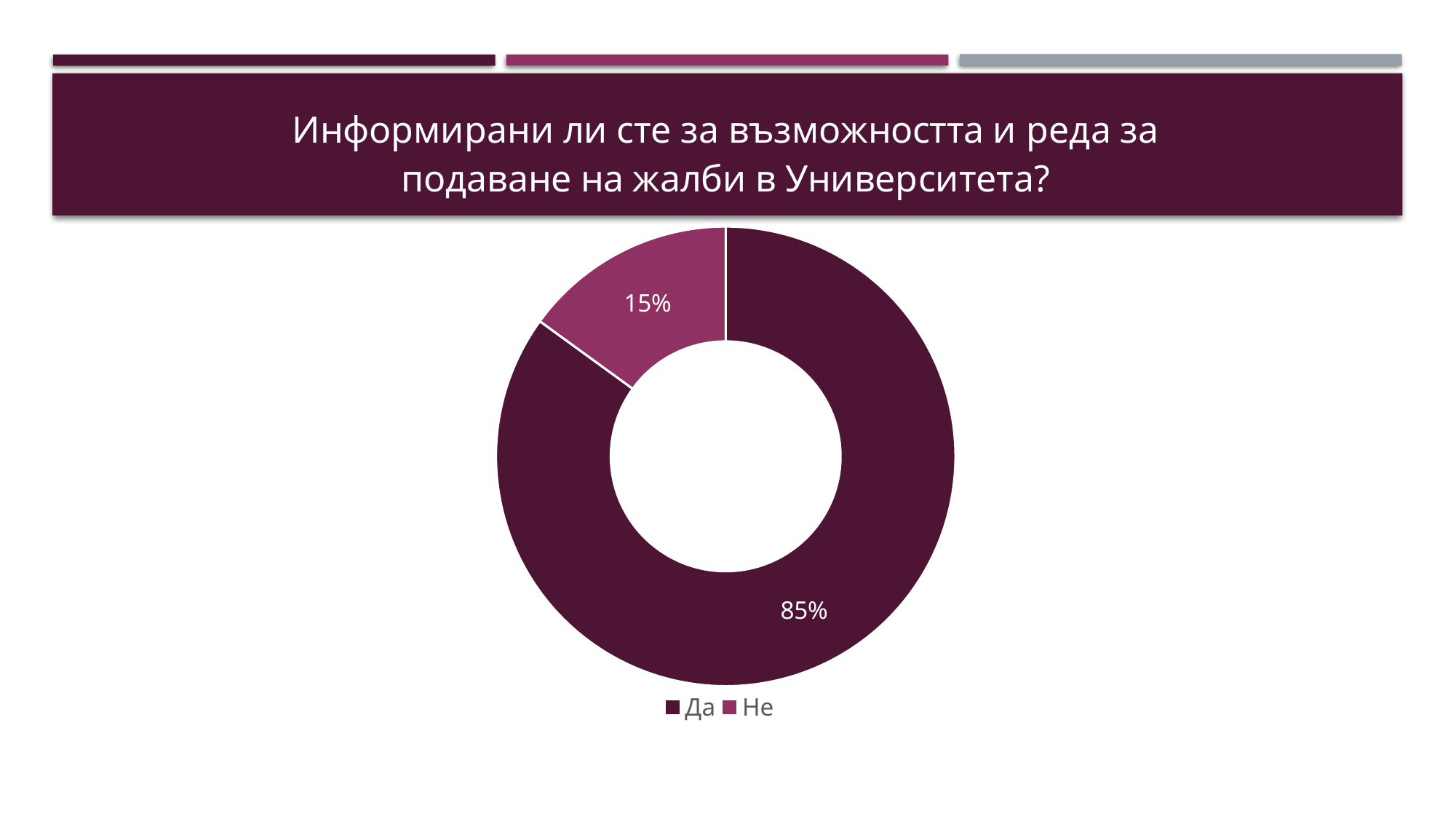
How many categories does the chart show? 2 What is the title of the chart? Информирани ли сте за възможността и реда за подаване на жалби в Университета? What percentage of respondents answered "Не"? 15% What is the difference in percentage points between the "Да" and "Не" shares? 70 Which is larger, the share for "Да" or the share for "Не"? Да What share of the chart does the "Не" slice represent? 15% What kind of chart is shown on the slide? Doughnut chart Which answer has the smallest share of the chart? Не What percentage of respondents answered "Да"? 85% Which answer has the largest share of the chart? Да Which legend entry is shown in the lighter magenta colour? Не